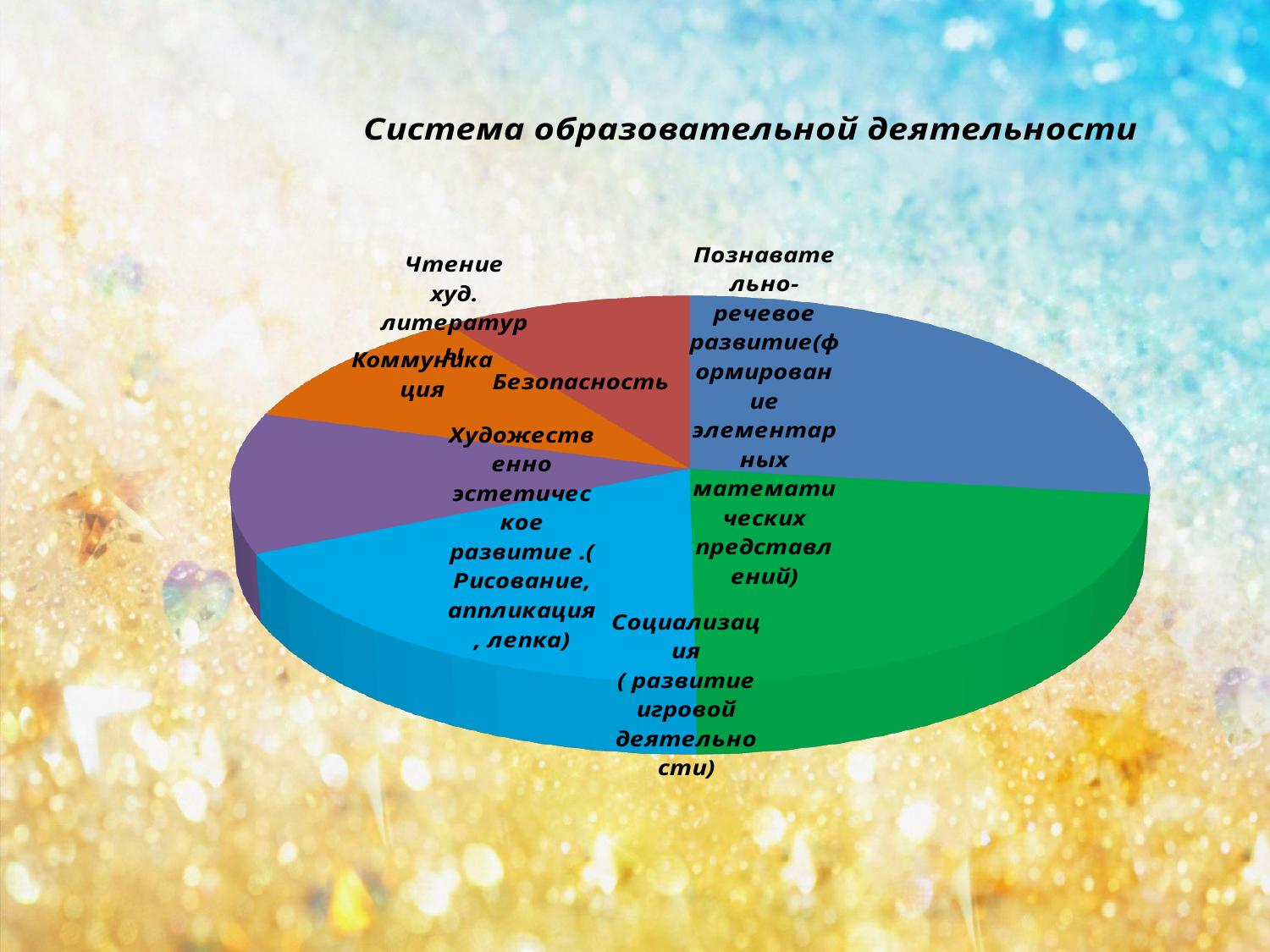
Which slice is larger: Художественно эстетическое развитие or Безопасность? Художественно эстетическое развитие Which slice is larger: Социализация or Коммуникация? Социализация Which slice is larger: Художественно эстетическое развитие or Чтение худ. литературы? Художественно эстетическое развитие How many slices does the pie chart have? 6 Which colour is the slice for Социализация (развитие игровой деятельности)? green What is the title of the chart? Система образовательной деятельности What kind of chart is shown on the slide? pie chart